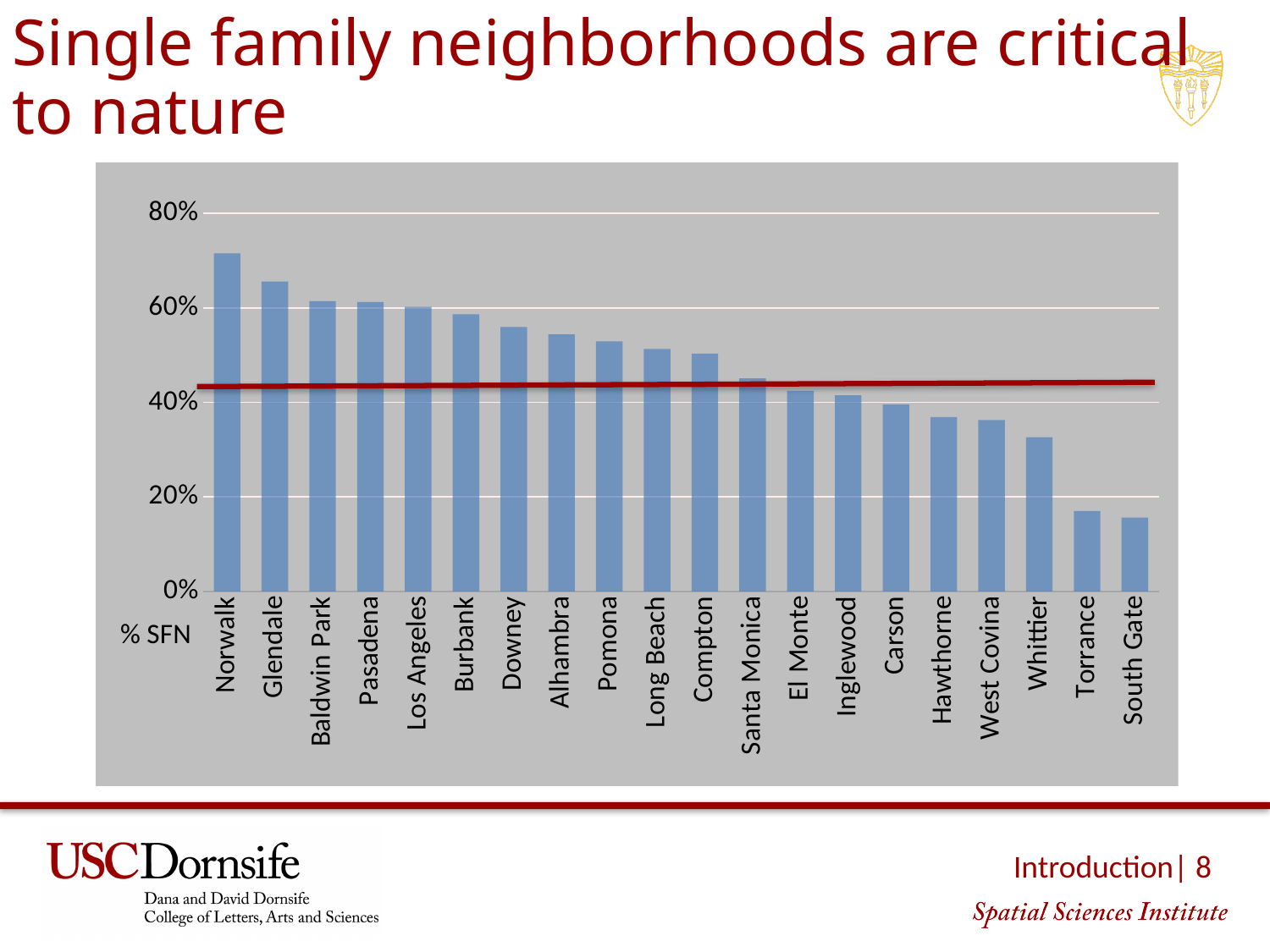
What label is shown at the bottom left of the chart's axis? % SFN Which city has the larger value, Norwalk or Glendale? Norwalk Is the value for Whittier greater or less than 40%? less What kind of chart is shown on the slide? Bar chart How many cities are shown on the x axis of the chart? 20 Which city has the highest % SFN value in the chart? Norwalk Is the value for Norwalk greater or less than 60%? greater Which city has the lowest % SFN value in the chart? South Gate Do the bar values rise or fall from left to right along the x axis? Fall Is the value for Torrance greater or less than 20%? less